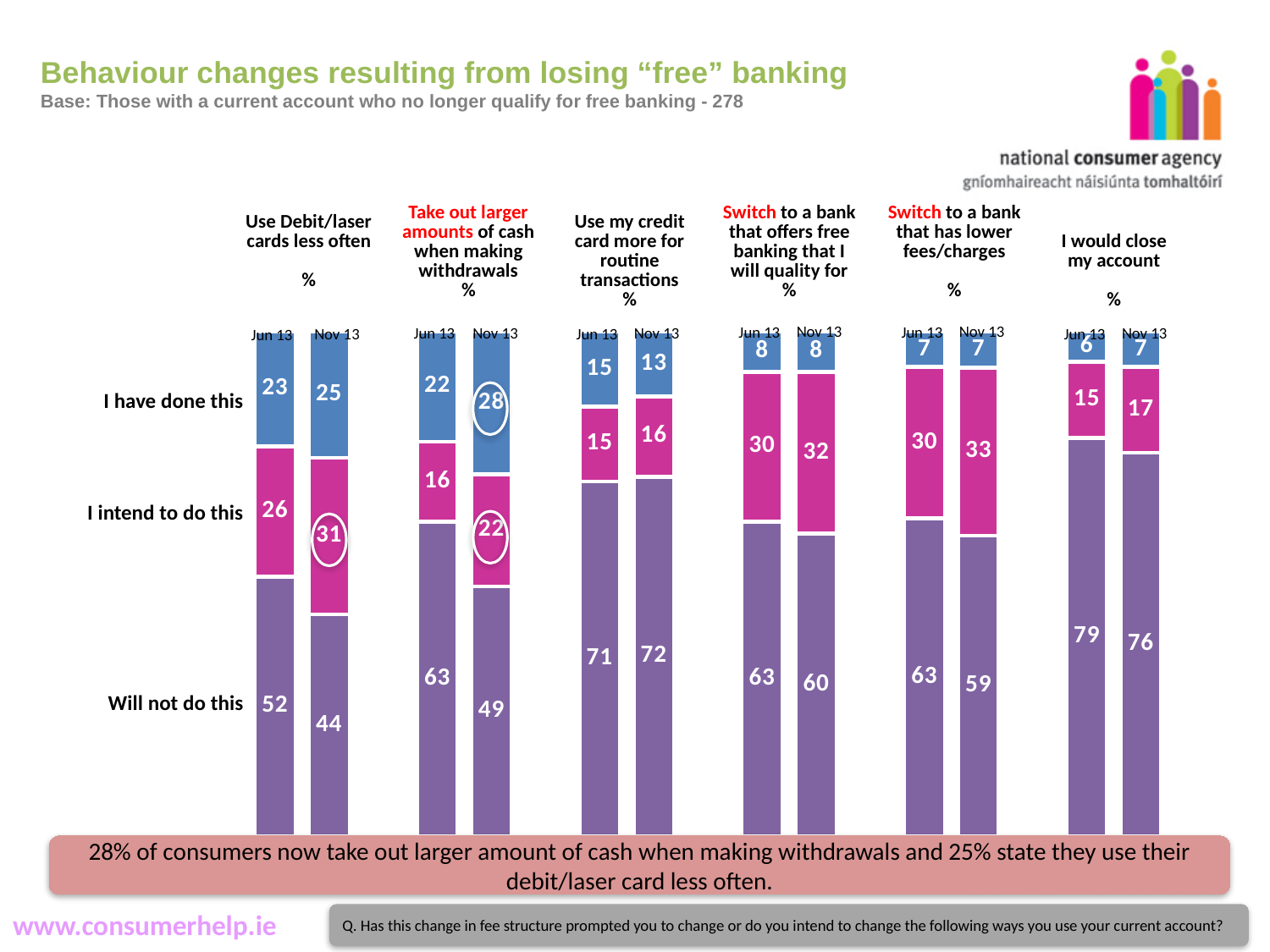
By how many percentage points did 'Will not do this' for using debit/laser cards less often fall from Jun 13 to Nov 13? 8 What type of chart is shown on the slide? Stacked bar chart How many response categories (segments) make up each stacked bar? 3 What percentage of respondents in Nov 13 said they will not switch to a bank that has lower fees/charges? 59 What is the total of the Nov 13 stacked bar for 'Switch to a bank that offers free banking that I will qualify for'? 100 What percentage of respondents in Nov 13 said they have already taken out larger amounts of cash when making withdrawals? 28 What percentage of respondents in Nov 13 said they intend to use their debit/laser cards less often? 31 How many behaviour changes are shown in the chart? 6 Which behaviour has the highest 'Will not do this' value in Jun 13? I would close my account What percentage of respondents in Jun 13 said they will not close their account? 79 Is the 'I have done this' value for using my credit card more for routine transactions larger in Jun 13 or Nov 13? Jun 13 Which behaviour has the lowest 'Will not do this' value in Nov 13? Use Debit/laser cards less often